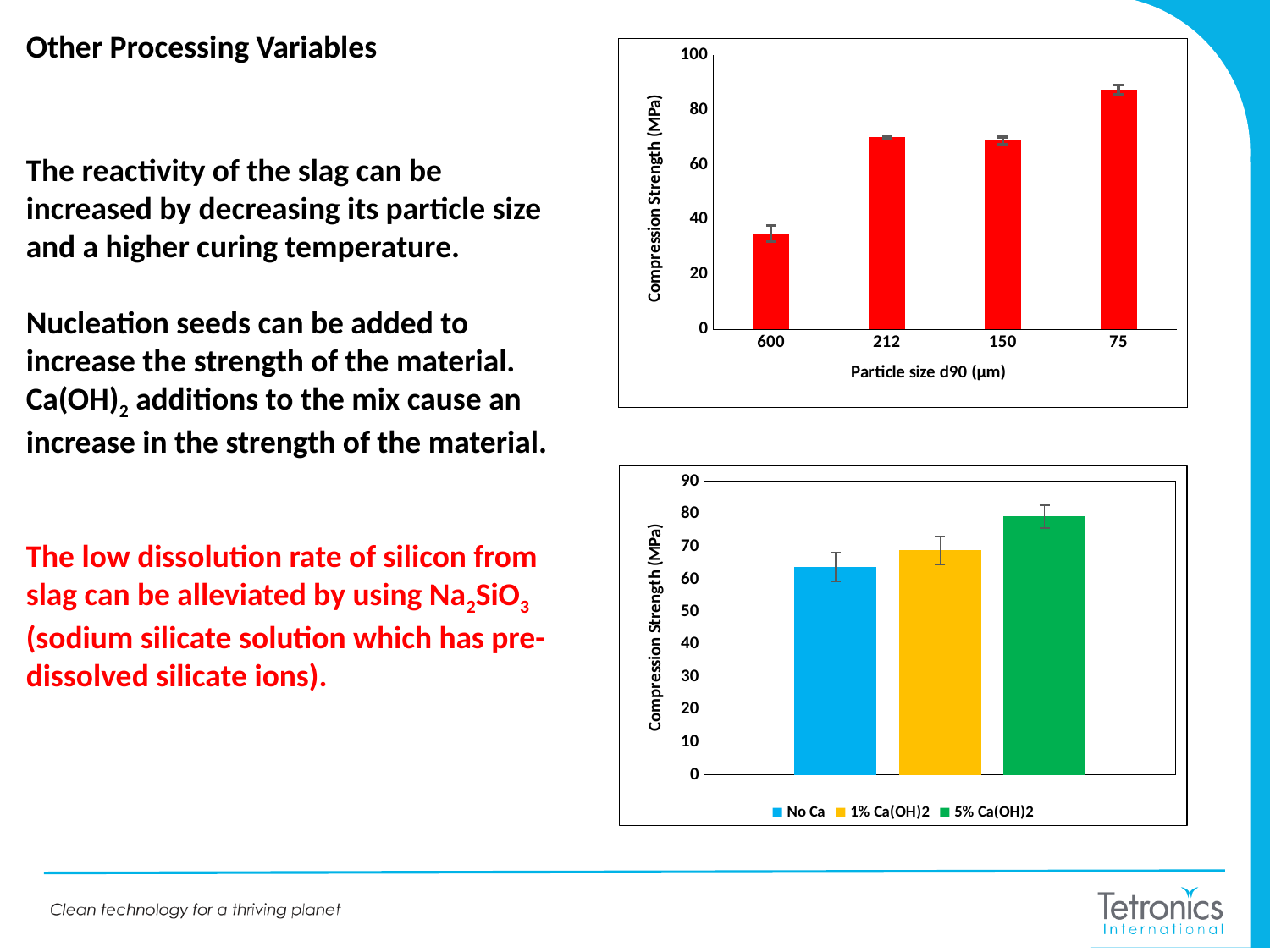
In the bottom chart, which series has the highest compression strength? 5% Ca(OH)2 In the bottom chart, how many series does the legend list? 3 In the top chart, is the compression strength for particle size 212 greater or less than 60? greater In the top chart, is the compression strength for particle size 75 greater or less than 80? greater In the bottom chart, is the compression strength for 5% Ca(OH)2 greater or less than 70? greater In the top chart, how many particle size categories are shown on the x axis? 4 In the top chart, which particle size has the highest compression strength? 75 What is the x-axis title of the top chart? Particle size d90 (µm) In the bottom chart, which is larger, the compression strength for No Ca or for 5% Ca(OH)2? 5% Ca(OH)2 In the top chart, which particle size has the lowest compression strength? 600 What kind of chart is the top chart on the slide? bar chart